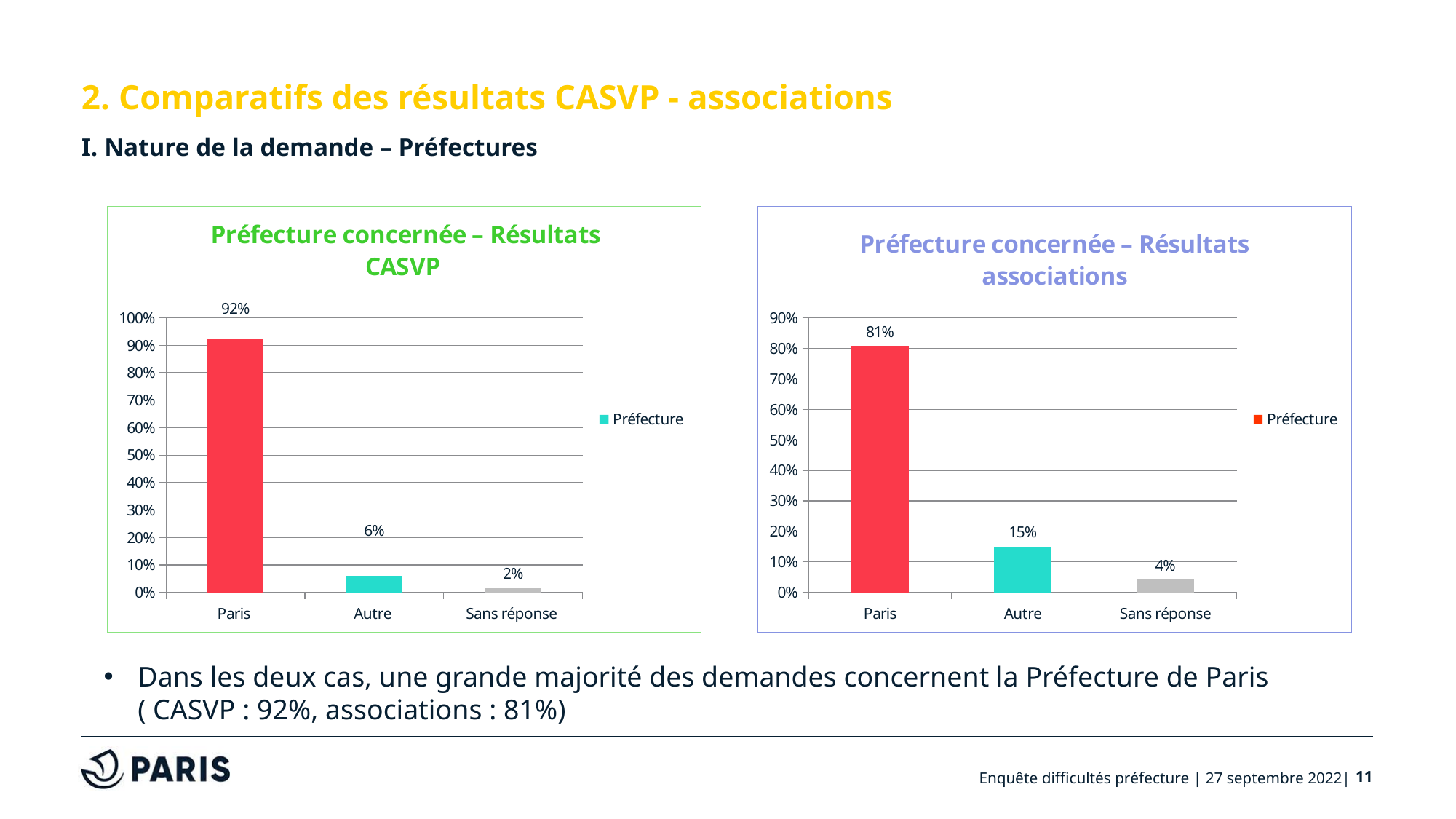
How many categories are shown on the x axis of the chart 'Préfecture concernée – Résultats CASVP'? 3 In the chart 'Préfecture concernée – Résultats CASVP', what is the value for Sans réponse? 2% In the chart 'Préfecture concernée – Résultats associations', what is the difference between the values for Paris and Autre? 66% In the chart 'Préfecture concernée – Résultats associations', which category has the highest value? Paris What kind of chart is 'Préfecture concernée – Résultats associations'? bar chart In the chart 'Préfecture concernée – Résultats associations', is the value for Paris greater or less than 70%? greater In the chart 'Préfecture concernée – Résultats CASVP', what is the difference between the values for Autre and Sans réponse? 4% In the chart 'Préfecture concernée – Résultats CASVP', which category has the lowest value? Sans réponse Which is larger: the value for Autre in the CASVP chart or the value for Autre in the associations chart? Autre in the associations chart In the chart 'Préfecture concernée – Résultats associations', what is the value for Autre? 15% How many series does the legend of the chart 'Préfecture concernée – Résultats CASVP' list? 1 In the chart 'Préfecture concernée – Résultats CASVP', what is the value for Paris? 92%